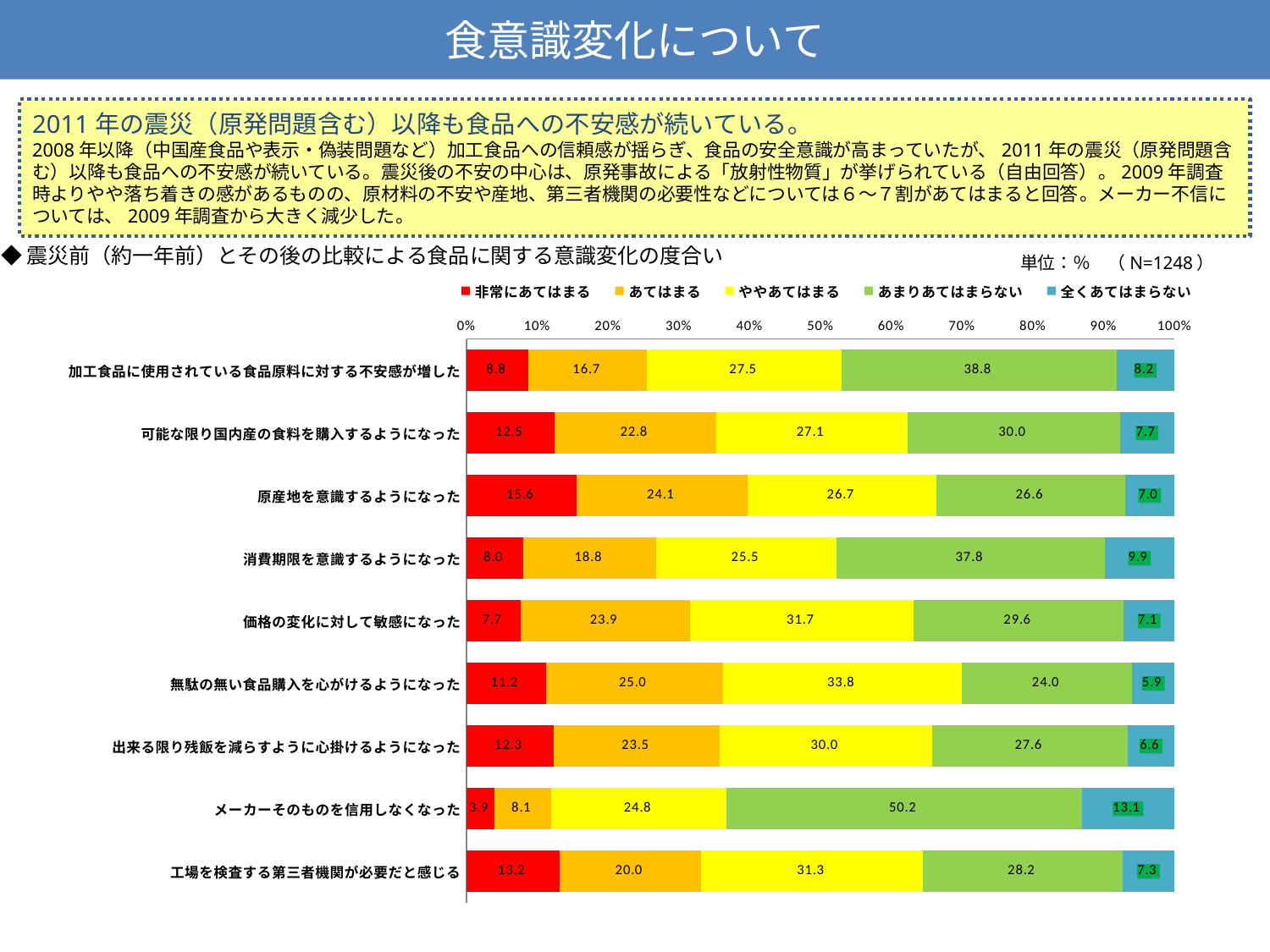
What type of chart is shown on the slide? Stacked bar chart What is the ややあてはまる value for 無駄の無い食品購入を心がけるようになった? 33.8 What is the 非常にあてはまる value for 原産地を意識するようになった? 15.6 What is the total of the stacked bar for 原産地を意識するようになった? 100.0 What is the sample size (N) shown on the slide? N=1248 What is the あまりあてはまらない value for メーカーそのものを信用しなくなった? 50.2 Which statement has the lowest 非常にあてはまる value? メーカーそのものを信用しなくなった Which statement has the highest 非常にあてはまる value? 原産地を意識するようになった Which is larger: the あてはまる value for 価格の変化に対して敏感になった or for 消費期限を意識するようになった? 価格の変化に対して敏感になった What is the difference between the あまりあてはまらない values for メーカーそのものを信用しなくなった and 無駄の無い食品購入を心がけるようになった? 26.2 How many series does the legend list? 5 How many categories (statements) are plotted in the chart? 9